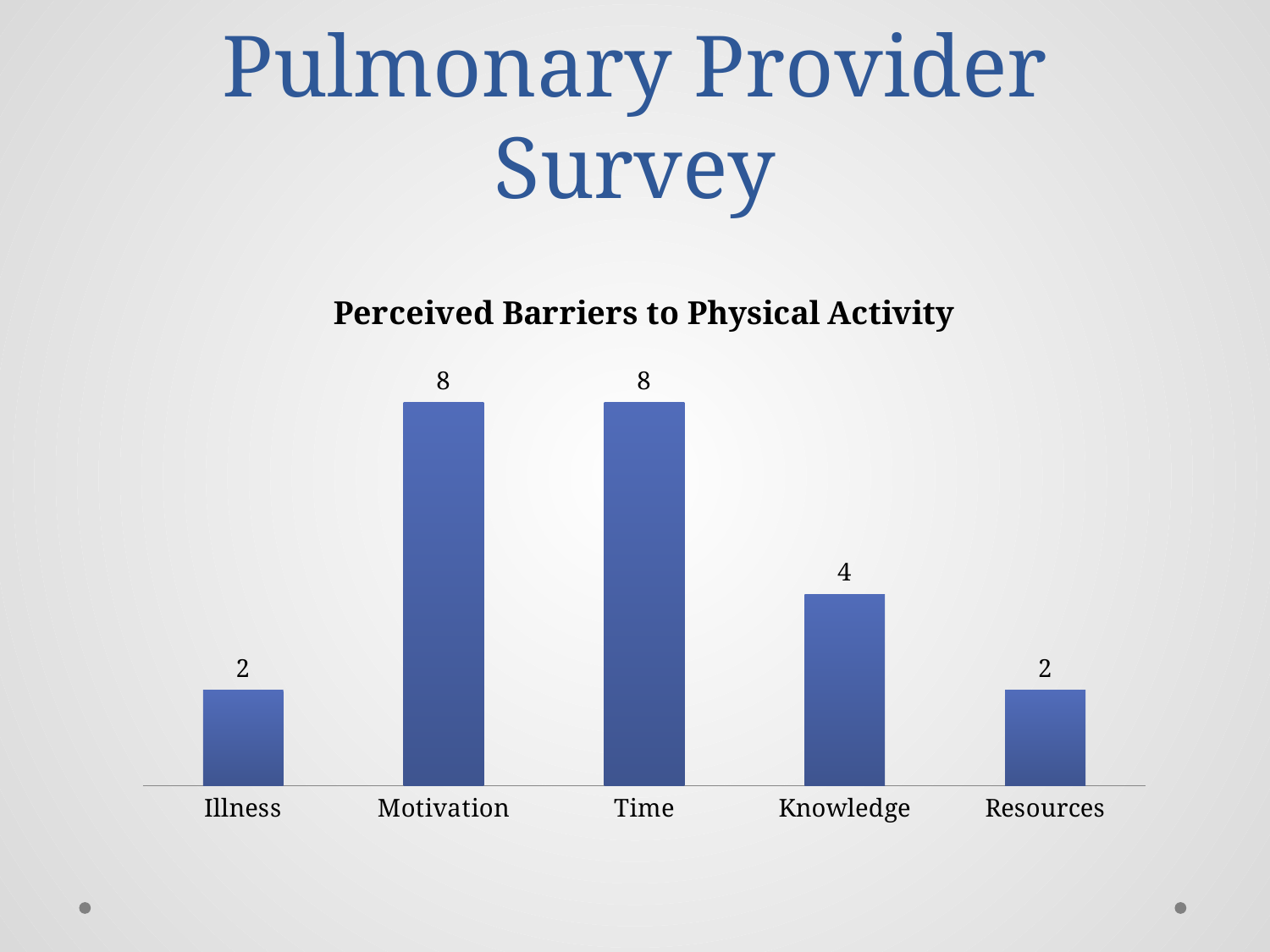
What is the value for Motivation? 8 What is the difference between the values for Time and Knowledge? 4 What is the value for Resources? 2 What is the difference between the values for Knowledge and Resources? 2 What is the value for Illness? 2 Which categories have the lowest value? Illness and Resources What is the value for Knowledge? 4 How many categories are shown on the x axis? 5 Which categories have the highest value? Motivation and Time Which is larger, the value for Motivation or the value for Knowledge? Motivation What is the title of the chart? Perceived Barriers to Physical Activity What kind of chart is shown on the slide? Bar chart